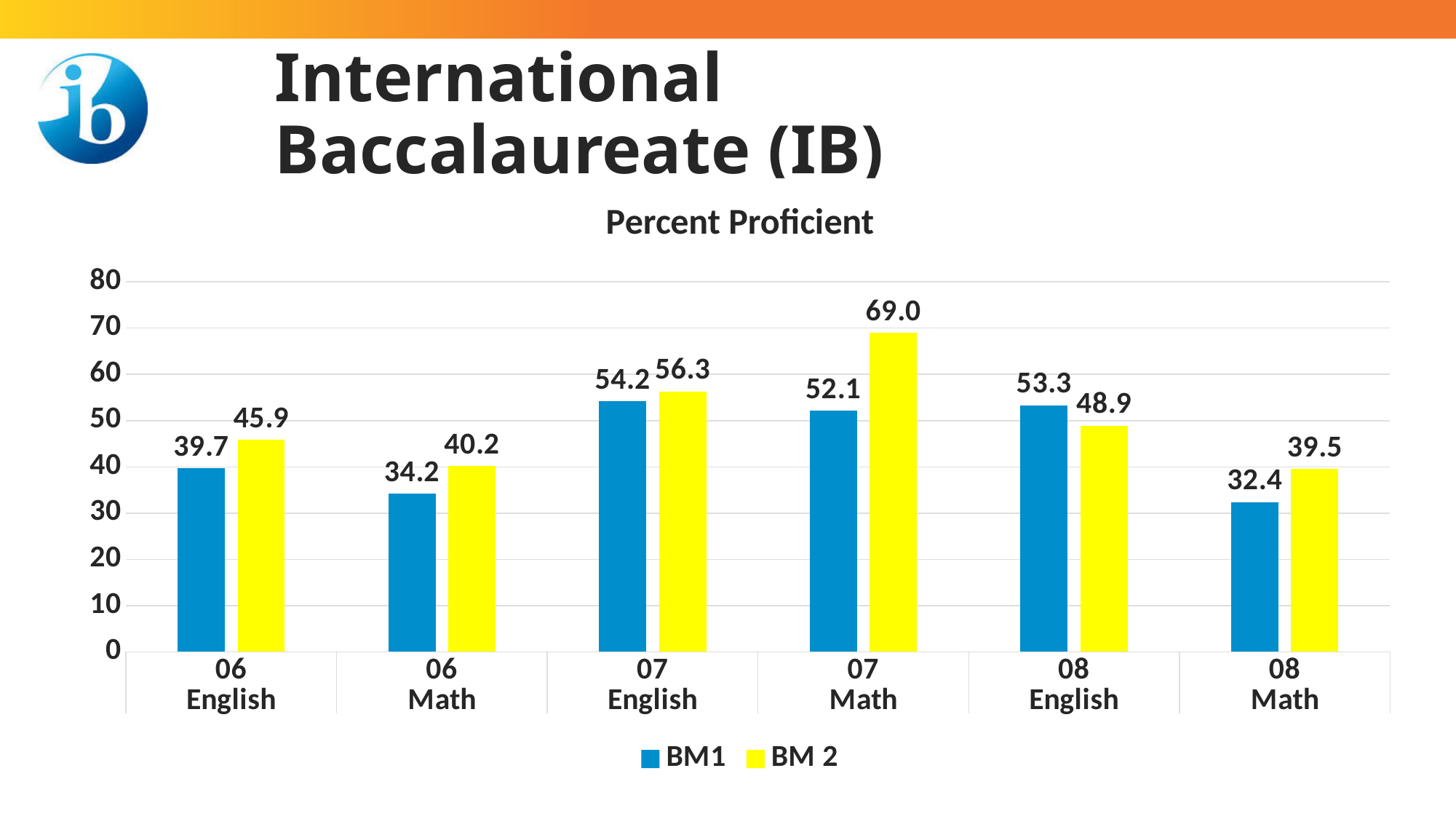
How many series does the legend list? 2 What is the title of the chart? Percent Proficient What kind of chart is shown on the slide? bar chart Which category has the highest BM 2 value? 07 Math How many categories are shown on the x axis? 6 What is the BM 2 value for 07 Math? 69.0 Is the BM 2 value for 06 Math greater or less than 50? less Which is larger for 08 English, BM1 or BM 2? BM1 What is the BM1 value for 06 English? 39.7 What is the difference between the BM 2 and BM1 values for 07 Math? 16.9 What is the BM1 value for 08 Math? 32.4 Which category has the lowest BM1 value? 08 Math